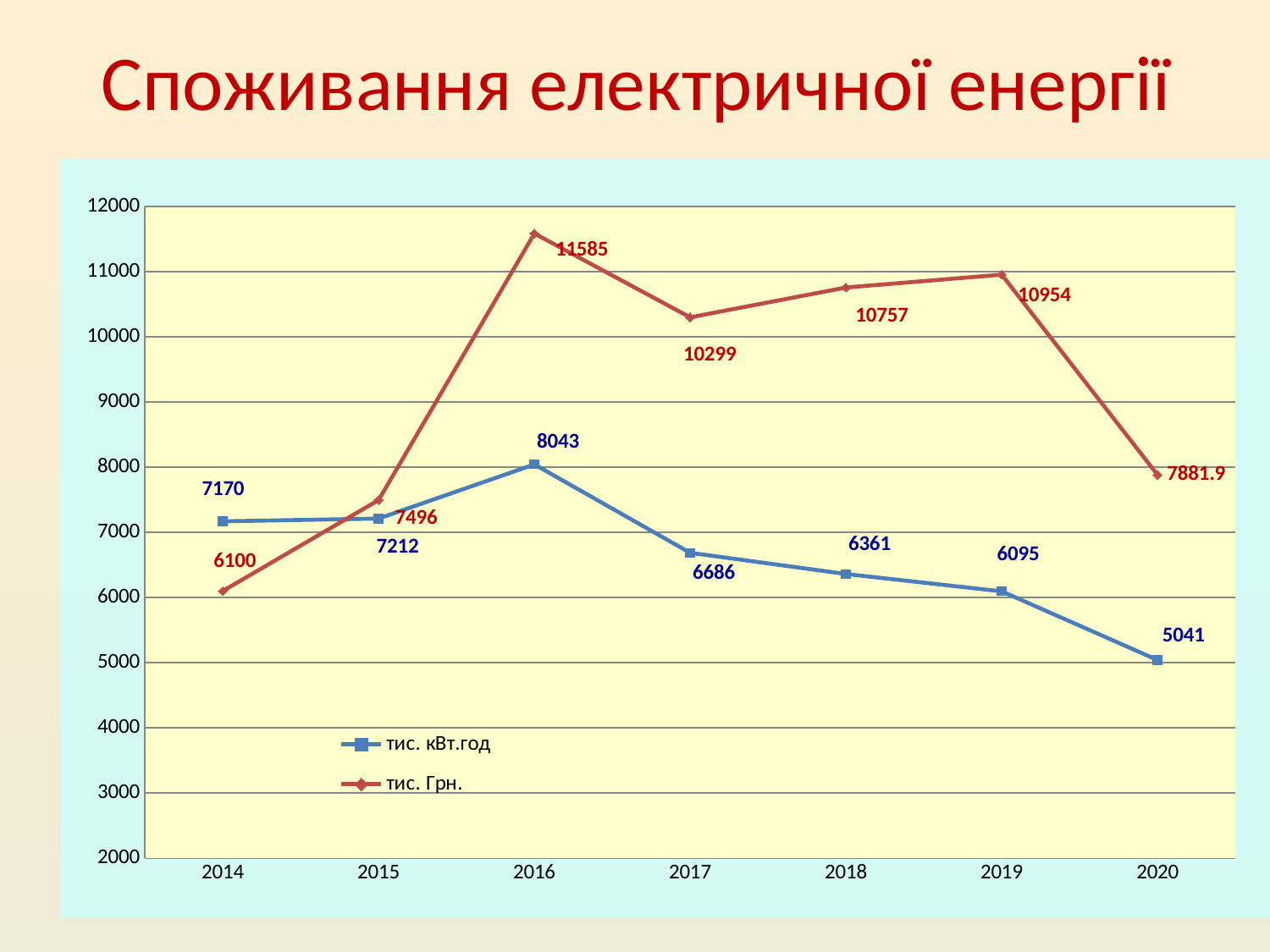
In which year is тис. Грн. highest? 2016 How many series does the legend list? 2 Which is larger in 2014: тис. кВт.год or тис. Грн.? тис. кВт.год What is the value of тис. кВт.год in 2016? 8043 What type of chart is shown on the slide? line chart What is the title of the slide? Споживання електричної енергії What is the value of тис. Грн. in 2020? 7881.9 What is the difference between тис. Грн. in 2016 and in 2017? 1286 Does тис. кВт.год rise or fall from 2016 to 2020? fall How many years are shown on the x axis? 7 In which year is тис. кВт.год lowest? 2020 What is the value of тис. Грн. in 2014? 6100